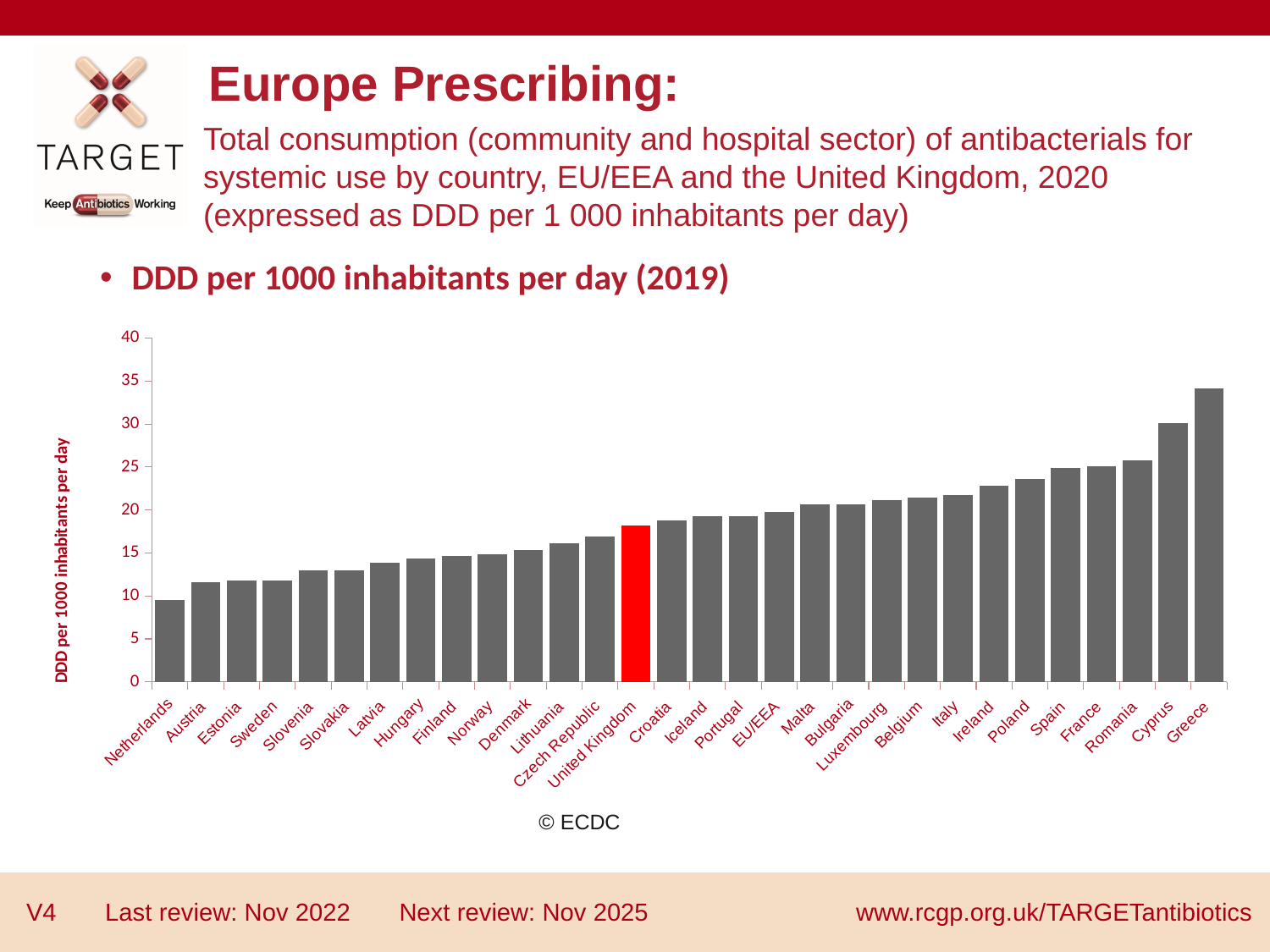
Is the value for Greece greater or less than 30? greater How many countries/regions are plotted on the x axis? 30 Which country has the lowest DDD per 1000 inhabitants per day? Netherlands Is the value for Poland greater or less than 20? greater Which bar is highlighted in red? United Kingdom Which country has the highest DDD per 1000 inhabitants per day? Greece Is the value for Cyprus greater or less than 35? less Do the values rise or fall moving from left to right along the x axis? rise Which has the larger value, Greece or Cyprus? Greece What kind of chart is shown on the slide? bar chart